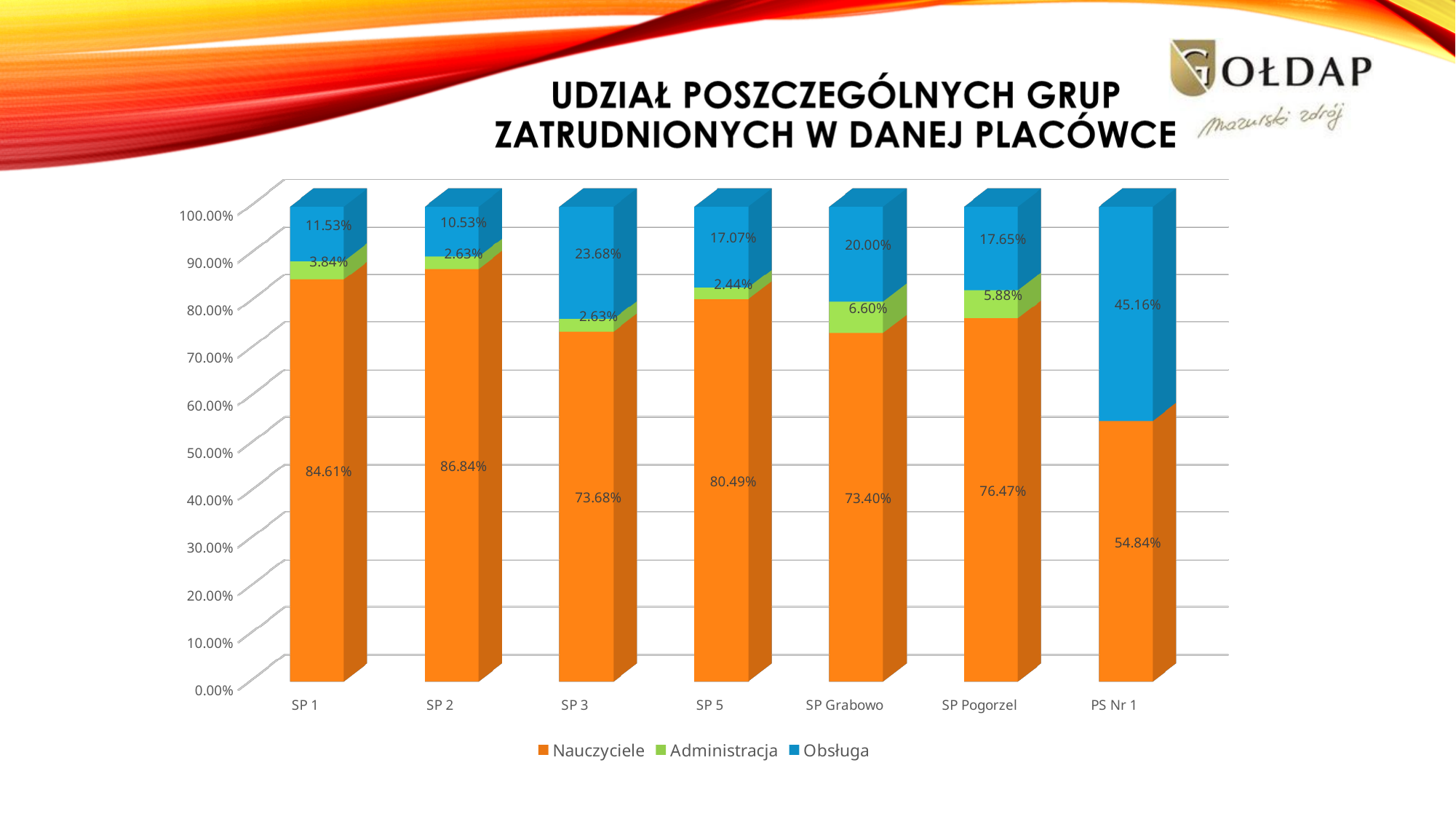
Which institution has the highest Nauczyciele share? SP 2 Which is larger, the Obsługa share for SP 3 or for SP Grabowo? SP 3 How many series does the legend list? 3 What kind of chart is shown on the slide? Stacked bar chart Which institution has the lowest Nauczyciele share? PS Nr 1 What is the Obsługa share for PS Nr 1? 45.16% Which series is shown in blue in the legend? Obsługa What is the difference in percentage points between the Nauczyciele share for SP 1 and for SP 3? 10.93 What is the Nauczyciele share for SP 2? 86.84% Which institution has the lowest Obsługa share? SP 2 What is the Administracja share for SP Grabowo? 6.60% How many institutions (categories) are shown on the x axis? 7